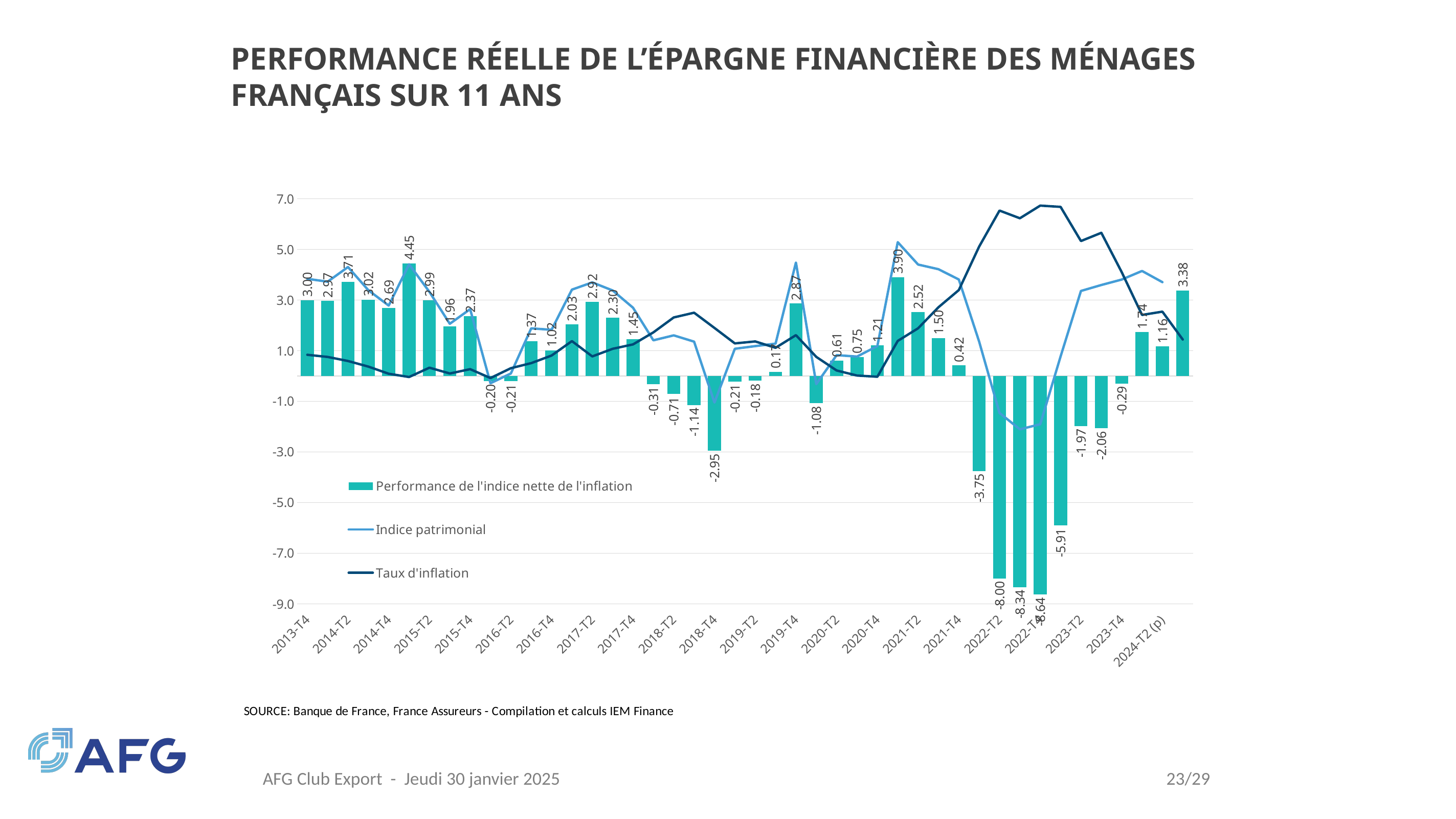
Which has the larger bar value, 2015-T2 or 2017-T2? 2015-T2 What is the difference between the bar values for 2019-T4 and 2021-T2? 0.35 Which legend entry is represented by the dark blue line? Taux d'inflation What is the value of the rightmost bar in the chart? 3.38 What is the highest bar value shown in the chart? 4.45 How many series does the legend list? 3 What kind of chart is shown on the slide? Bar chart with two line series Which quarter has the lowest 'Performance de l'indice nette de l'inflation' bar? 2022-T4 What is the value of the 'Performance de l'indice nette de l'inflation' bar for 2022-T4? -8.64 What is the value of the 'Performance de l'indice nette de l'inflation' bar for 2018-T4? -2.95 Is the 'Taux d'inflation' line value at 2022-T4 greater or less than 5.0? greater What is the value of the 'Performance de l'indice nette de l'inflation' bar for 2013-T4? 3.00